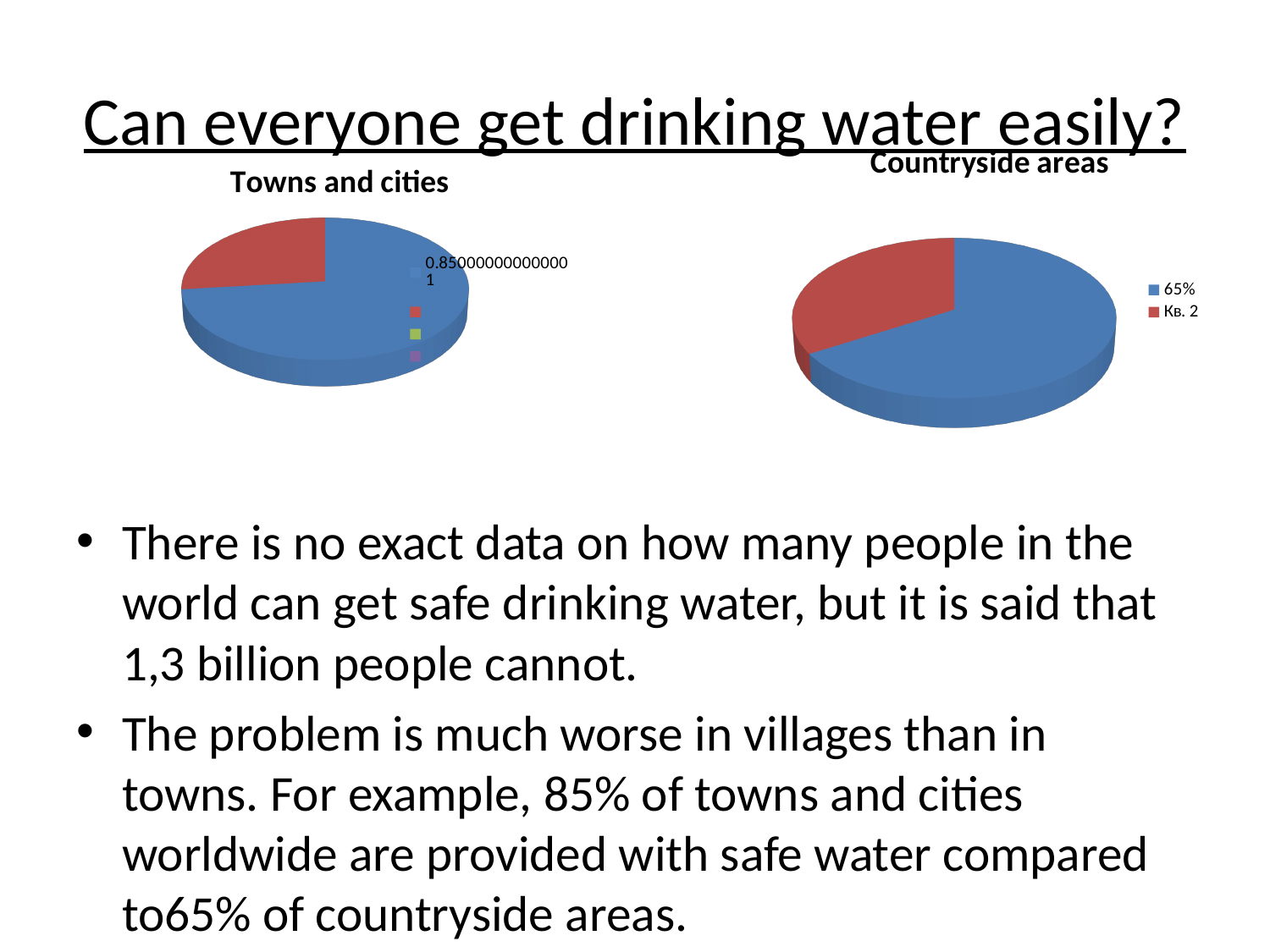
What is the title of the pie chart on the left of the slide? Towns and cities In the "Countryside areas" chart, which slice is the smallest? The red slice (Кв. 2) In the "Towns and cities" chart, which slice is the largest? The blue slice How many entries does the legend of the "Countryside areas" chart list? 2 How many slices are visible in the "Countryside areas" pie chart? 2 In the "Countryside areas" chart, which slice is larger, the blue one or the red one? The blue one What kind of chart is the "Towns and cities" chart? Pie chart What kind of chart is the "Countryside areas" chart? Pie chart How many slices are visible in the "Towns and cities" pie chart? 2 What is the first legend entry of the "Countryside areas" chart? 65% In the "Towns and cities" chart, which slice is larger, the blue one or the red one? The blue one